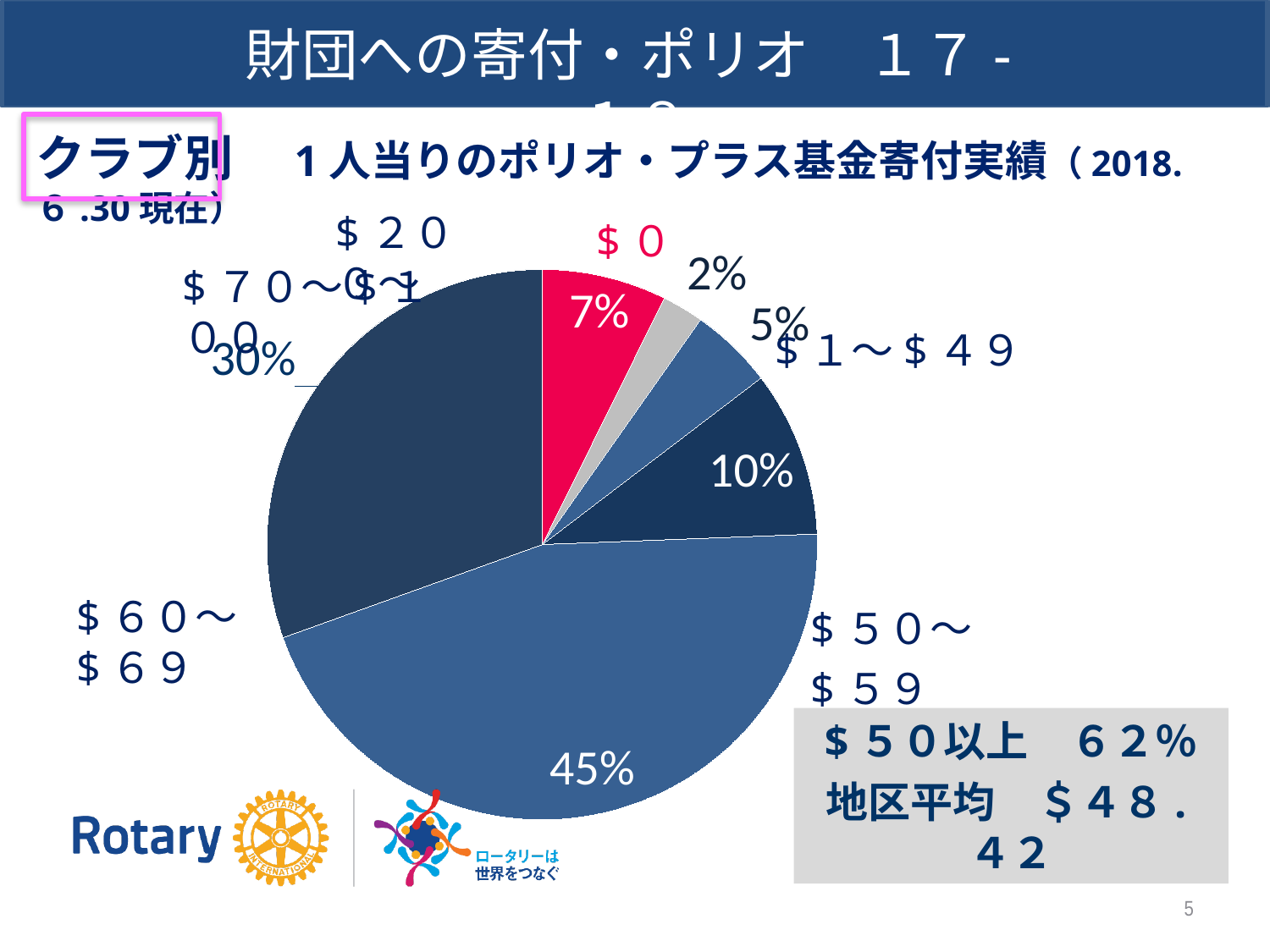
Which is larger, the 30% slice or the 45% slice? the 45% slice Which slice of the pie is the largest? the $50～$59 slice (45%) What is the difference in percentage points between the 30% slice and the 10% slice? 20 What colour is the $0 slice of the pie? red What share of the pie does the $0 slice represent? 7% What is the percentage of the smallest slice in the pie? 2% What kind of chart is shown on the slide? pie chart What is the district average (地区平均) stated in the box next to the pie chart? $48.42 How many slices does the pie chart have? 6 What is the difference in percentage points between the largest slice (45%) and the smallest slice (2%)? 43